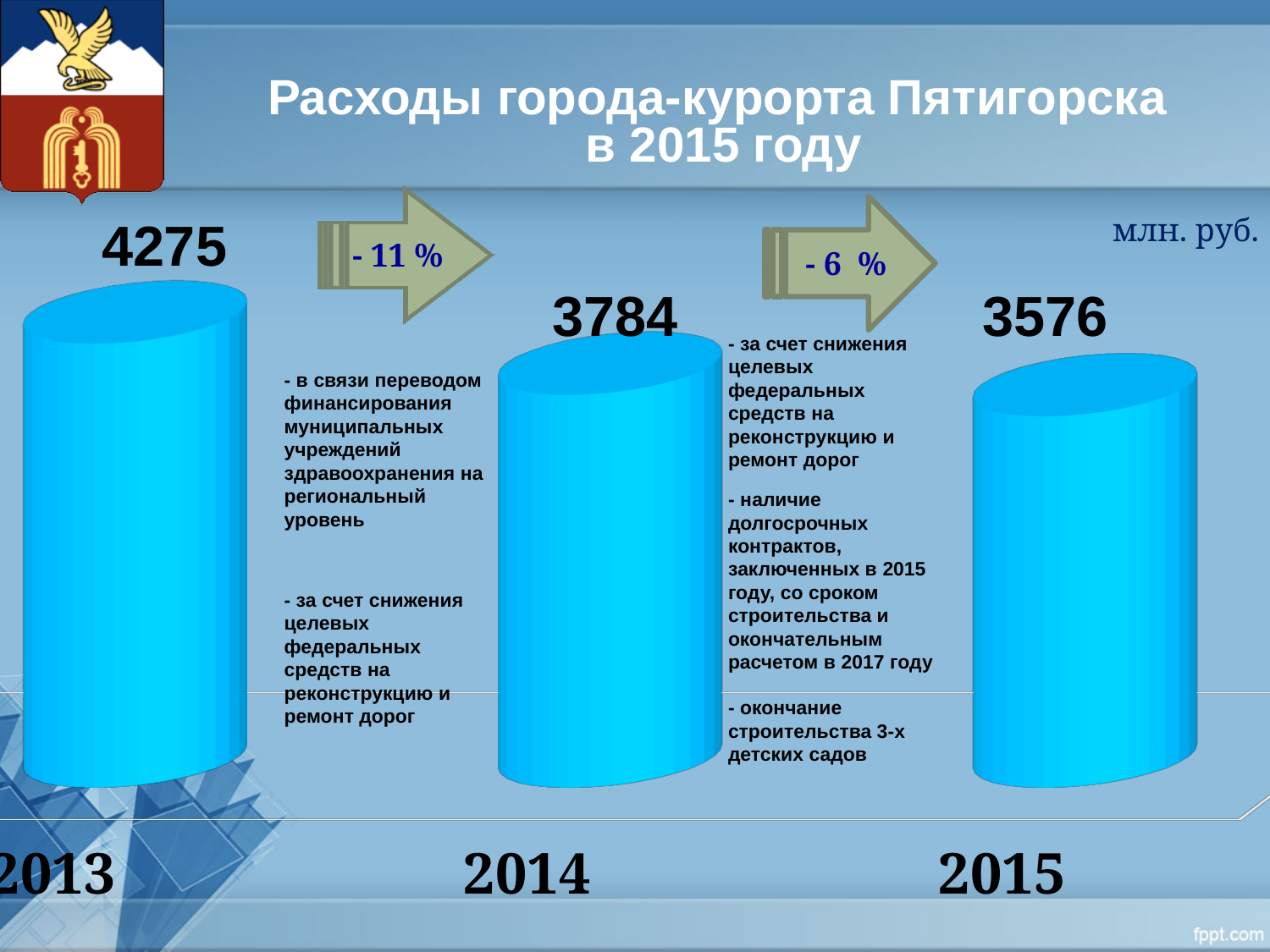
How many years are shown on the chart? 3 Which is larger, the value for 2014 or the value for 2015? 2014 Which year has the lowest value? 2015 What is the difference between the values for 2014 and 2015? 208 What is the value for 2013? 4275 What kind of chart is this? bar chart What is the difference between the values for 2013 and 2014? 491 Which year has the highest value? 2013 What is the value for 2015? 3576 What is the value for 2014? 3784 Do the values rise or fall from 2013 to 2015? fall What percentage change is shown between 2014 and 2015? - 6 %